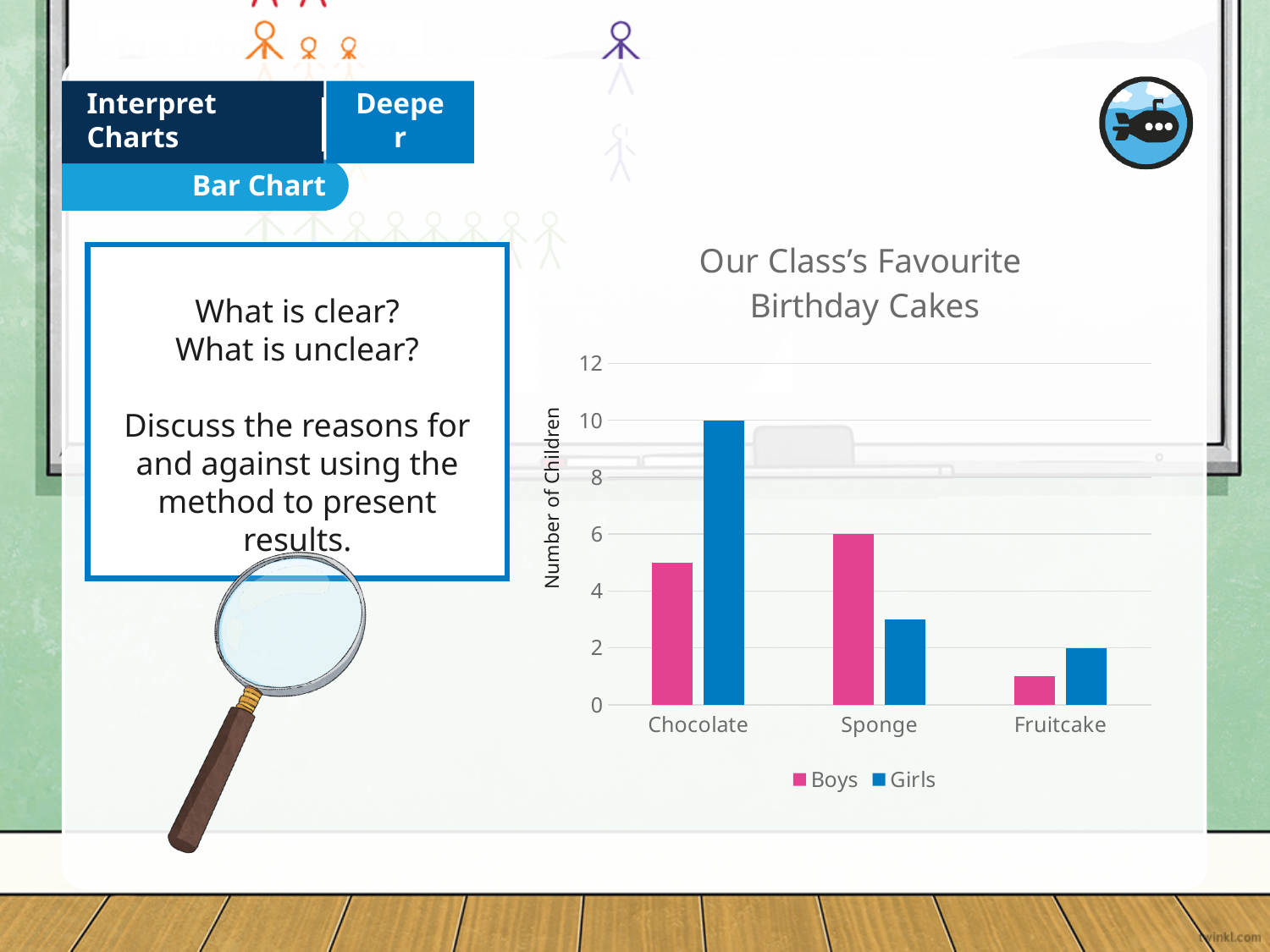
What is the difference between the number of girls who chose Chocolate and the number of girls who chose Fruitcake? 8 How many boys chose Sponge as their favourite birthday cake? 6 How many cake categories are shown on the x axis? 3 Which cake has the highest value for Girls? Chocolate Is the value for Boys choosing Chocolate greater or less than 4? greater What type of chart is shown on the slide? Bar chart What is the title of the chart? Our Class's Favourite Birthday Cakes How many girls chose Chocolate as their favourite birthday cake? 10 For Sponge, which is larger, the value for Boys or the value for Girls? Boys How many series does the legend list? 2 Which cake has the lowest value for Boys? Fruitcake How many girls chose Fruitcake as their favourite birthday cake? 2